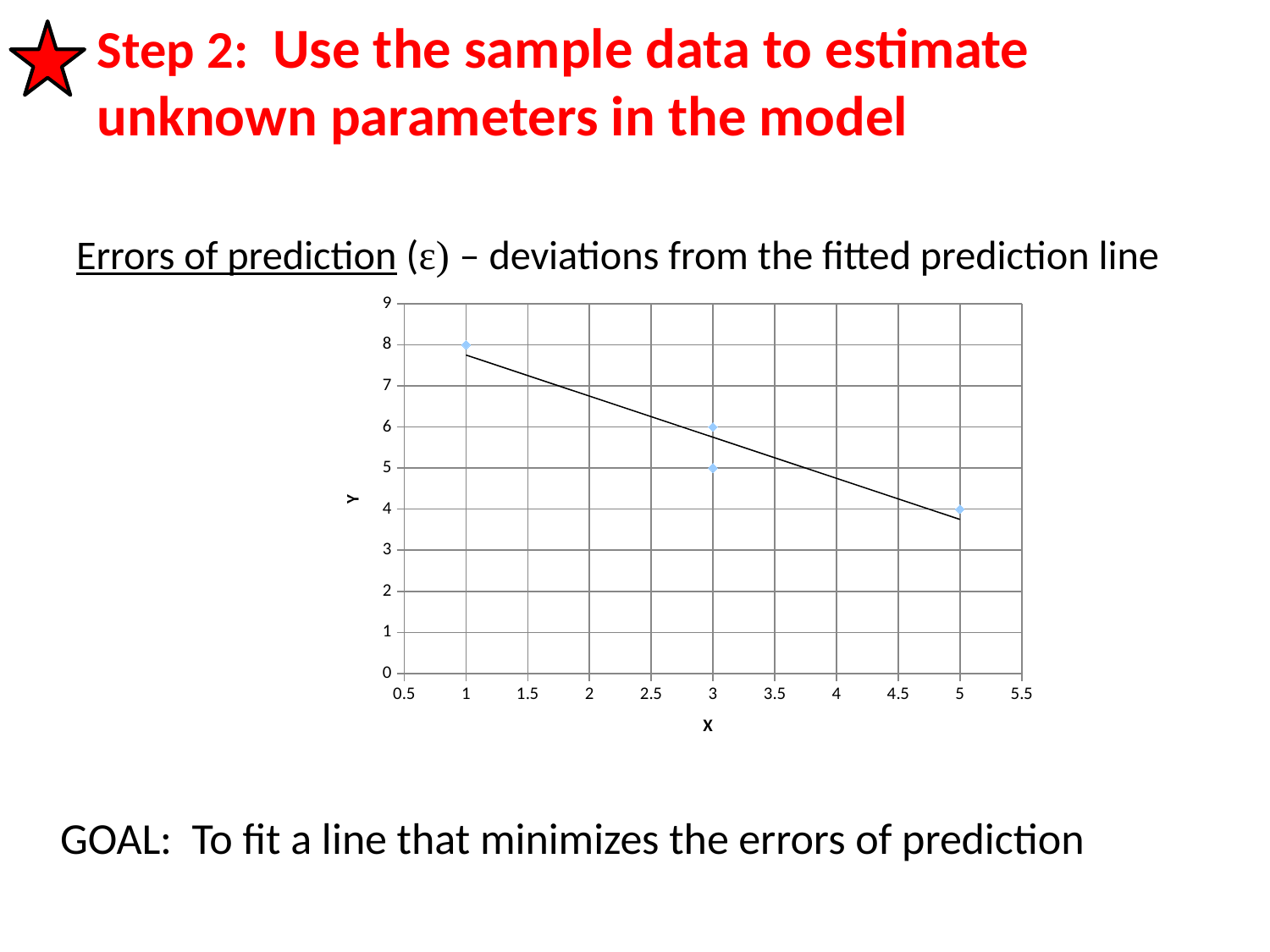
Which data point has the lowest Y value? the point at X = 5 (Y = 4) What is the label on the vertical axis of the chart? Y What is the Y value of the data point at X = 5? 4 Do the Y values of the data points rise or fall as X increases? fall What is the label on the horizontal axis of the chart? X Is the Y value of the point at X = 1 larger than the Y value of the point at X = 5? yes What are the Y values of the two data points at X = 3? 6 and 5 What is the difference in Y between the point at X = 1 and the point at X = 5? 4 What is the Y value of the data point at X = 1? 8 What kind of chart is shown on the slide? scatter plot How many data points are plotted on the chart? 4 Which data point has the highest Y value? the point at X = 1 (Y = 8)